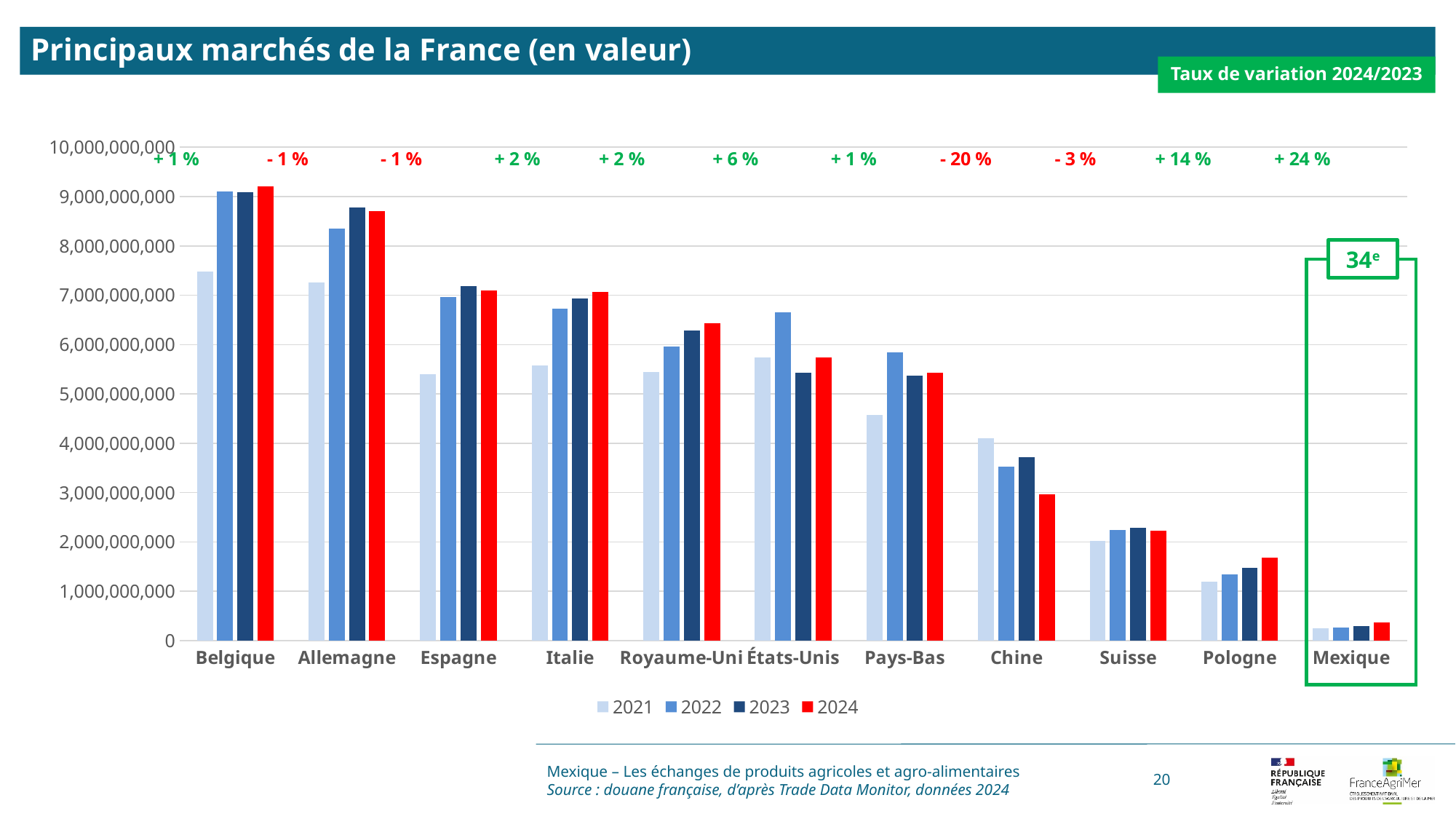
What is the 2024/2023 variation rate printed above Mexique? + 24 % What kind of chart is shown on the slide? bar chart Do the 2024 values generally rise or fall moving from Belgique to Mexique along the x axis? fall How many series does the legend list? 4 Which is larger, the 2024 value for Chine or the 2024 value for Suisse? Chine Which country has the lowest 2024 value? Mexique Which country has the highest 2024 value? Belgique How many countries are shown on the x axis of the chart? 11 Is the 2024 value for Belgique greater or less than 9,000,000,000? greater What is the title of the chart? Principaux marchés de la France (en valeur) What is the 2024/2023 variation rate printed above Chine? - 20 % Is the 2024 value for Pologne greater or less than 2,000,000,000? less